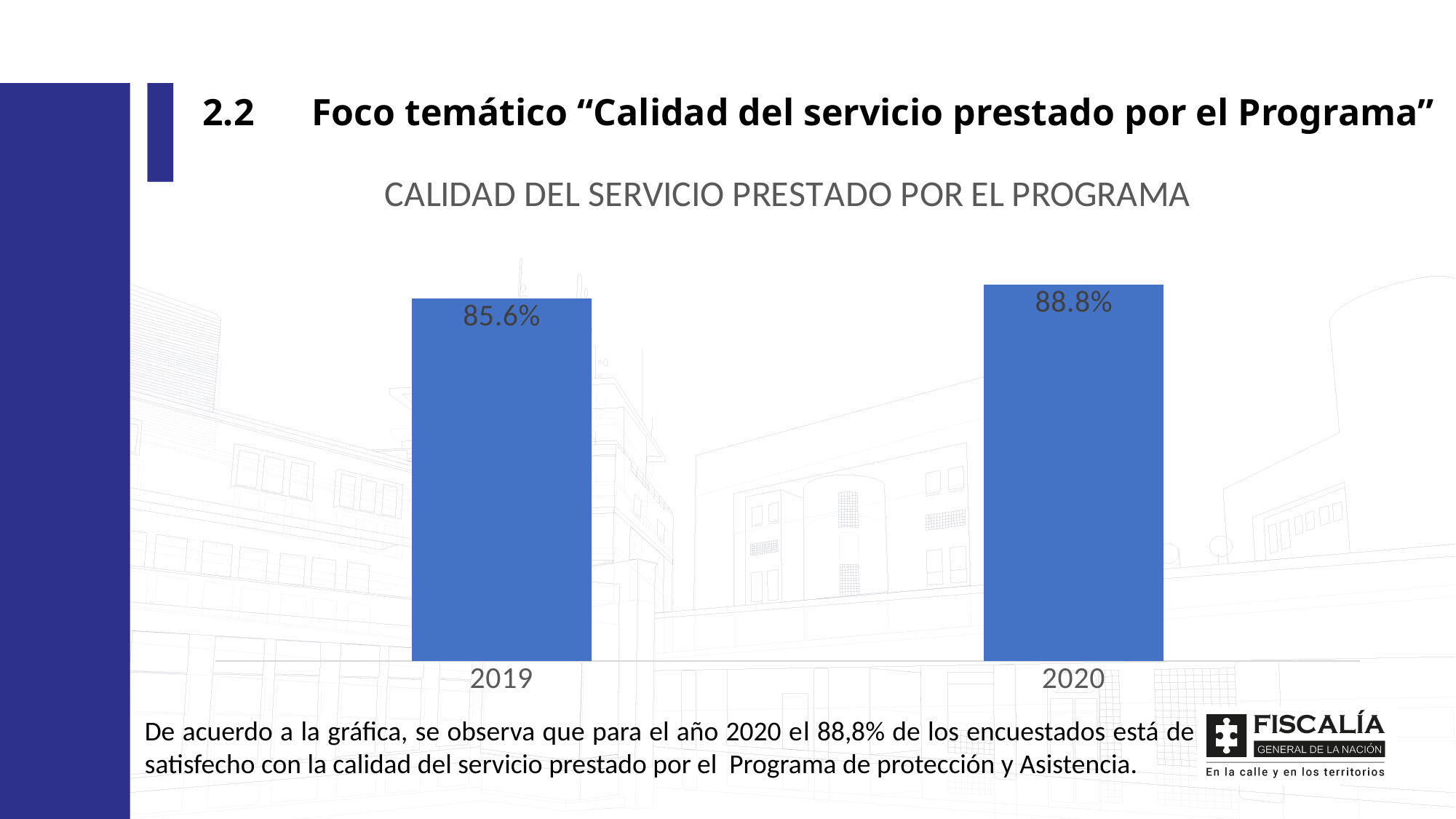
Which year has the highest value? 2020 What kind of chart is shown on the slide? Bar chart What is the value for 2019? 85.6% How many categories are shown in the chart? 2 Which year has the lowest value? 2019 What is the title of the chart? CALIDAD DEL SERVICIO PRESTADO POR EL PROGRAMA What colour are the bars in the chart? Blue What is the difference between the values for 2020 and 2019? 3.2% Do the values rise or fall from 2019 to 2020? Rise Which is larger, the value for 2019 or the value for 2020? 2020 What is the value for 2020? 88.8%